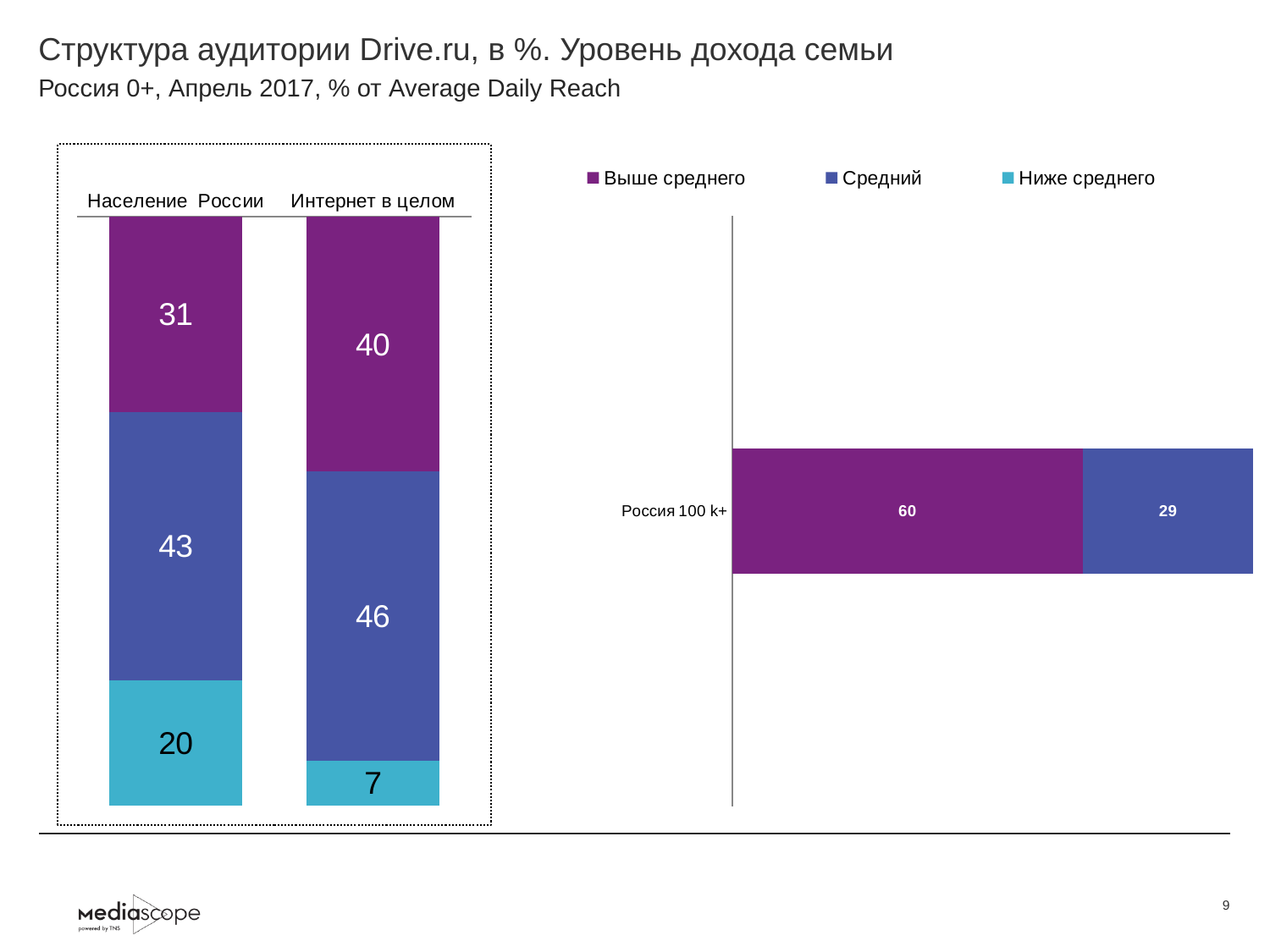
In the right chart, what is the value of the 'Средний' segment for 'Россия 100 k+'? 29 How many series does the legend list? 3 In the right chart, what is the value of the 'Выше среднего' segment for 'Россия 100 k+'? 60 In the left chart, what is the value of the 'Ниже среднего' segment for 'Интернет в целом'? 7 How many categories are shown in the left chart? 2 In the left chart, which segment is the smallest for 'Интернет в целом'? Ниже среднего In the left chart, which category has the larger 'Выше среднего' value, 'Население России' or 'Интернет в целом'? Интернет в целом In the left chart, what is the value of the 'Выше среднего' segment for 'Население России'? 31 What kind of chart is the right chart? Stacked bar chart In the left chart, what is the value of the 'Средний' segment for 'Интернет в целом'? 46 In the left chart, what is the total of the stacked bar for 'Население России'? 94 In the left chart, what is the difference between the 'Ниже среднего' values for 'Население России' and 'Интернет в целом'? 13